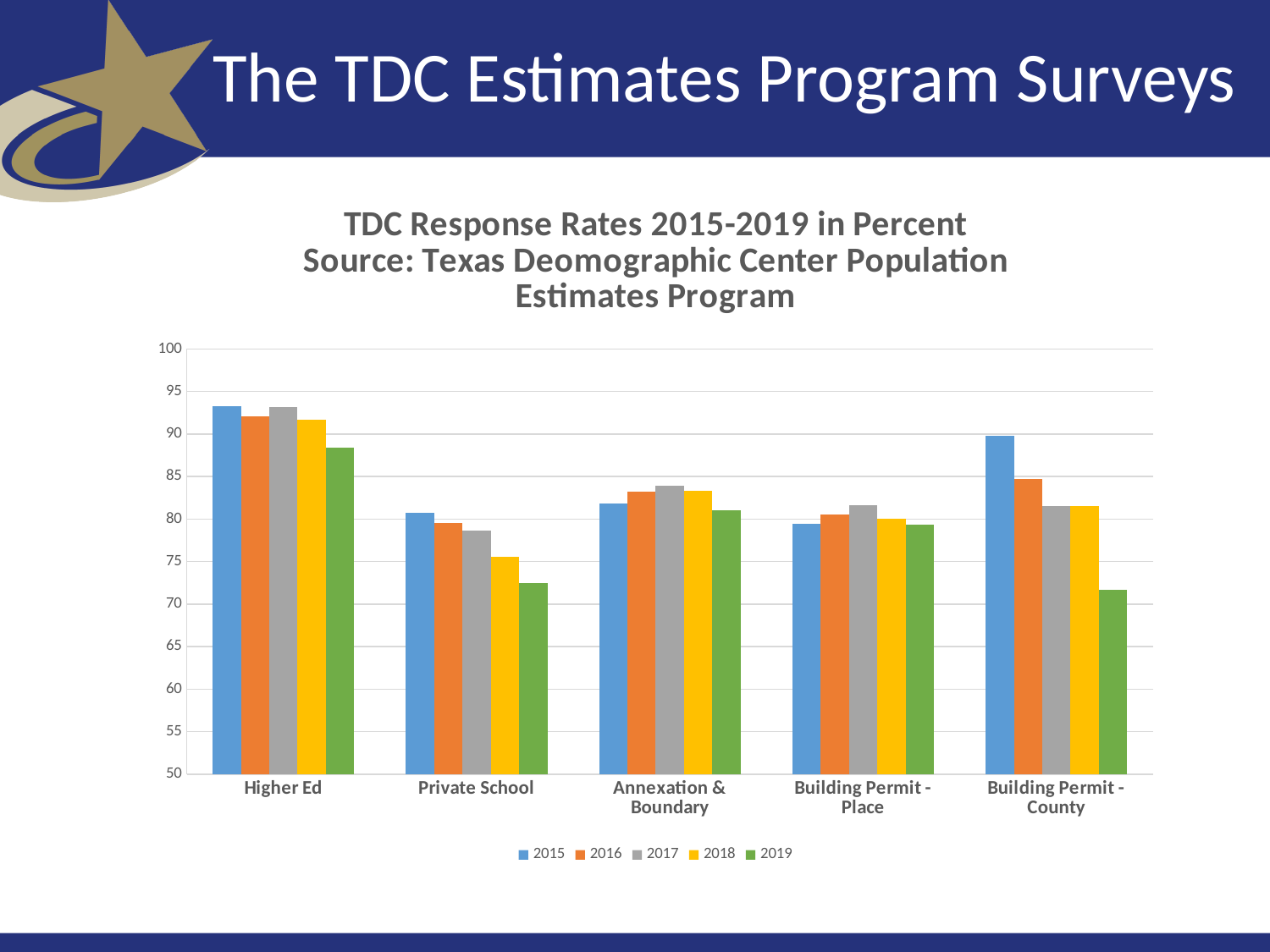
Which category has the lowest response rate for 2018? Private School Do the Private School response rates rise or fall from 2015 to 2019? fall Which category has the highest response rate for 2015? Higher Ed Is the 2019 value for Higher Ed greater or less than 90? less Which year is listed first in the legend? 2015 What kind of chart is shown on the slide? bar chart How many survey categories are shown along the x axis? 5 Is the 2017 value for Annexation & Boundary greater or less than 80? greater Is the 2015 value for Building Permit - County greater or less than 85? greater How many series does the legend list? 5 Which is larger, the 2015 value for Higher Ed or the 2015 value for Building Permit - County? Higher Ed